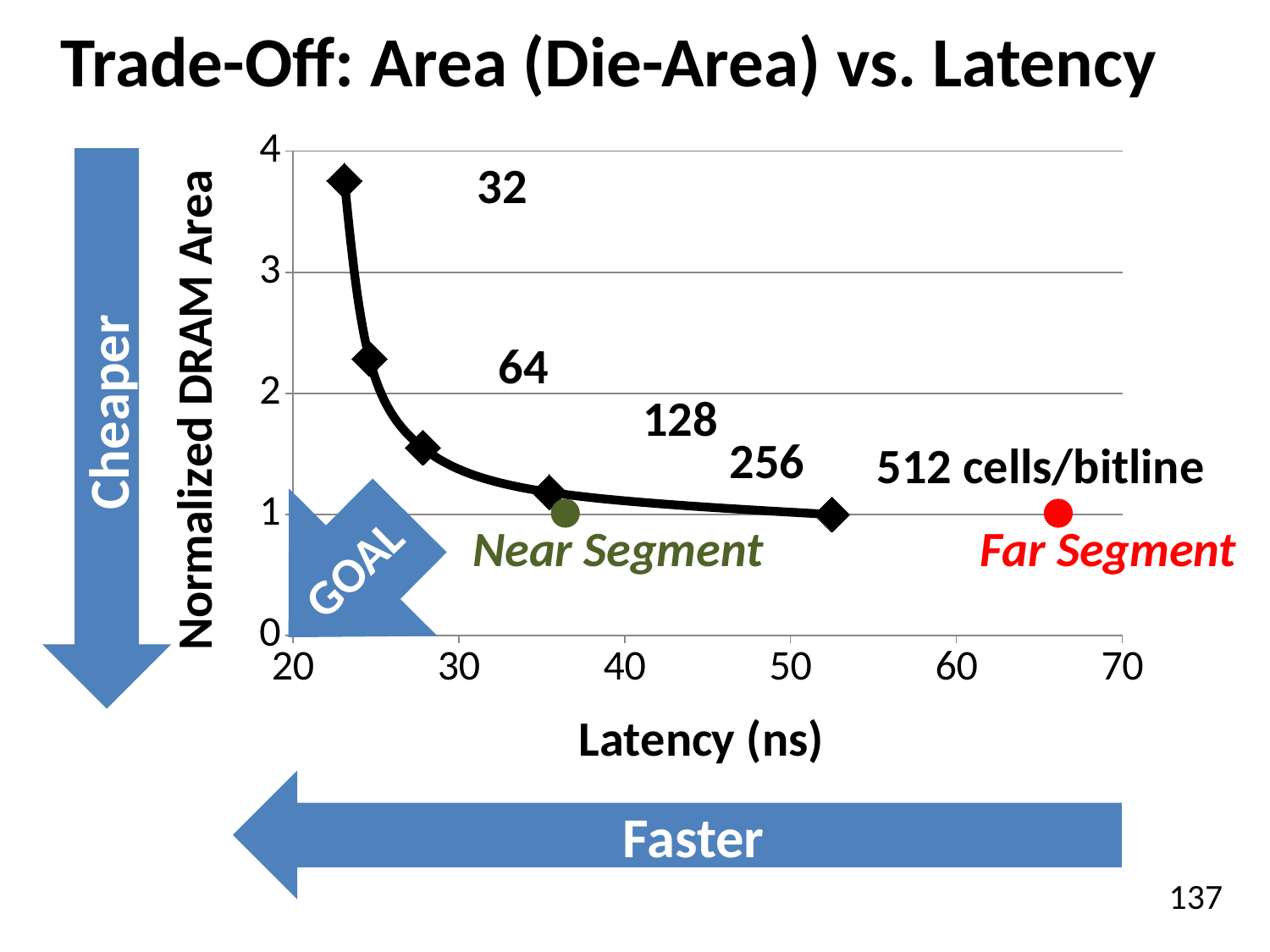
Is the normalized DRAM area for 64 cells/bitline greater or less than 2? greater Which cells/bitline configuration has the highest normalized DRAM area? 32 Is the normalized DRAM area for 128 cells/bitline greater or less than 2? less What kind of chart is shown on the slide? line chart Is the latency of the Far Segment point greater or less than 60 ns? greater Which cells/bitline configuration has the lowest normalized DRAM area? 512 Which has the higher latency, the 32 cells/bitline point or the 512 cells/bitline point? 512 cells/bitline What is the label of the x axis? Latency (ns) How many cells/bitline configurations are labeled on the black curve? 5 What is the title of the chart on the slide? Trade-Off: Area (Die-Area) vs. Latency As latency increases along the x axis, does the normalized DRAM area rise or fall? fall